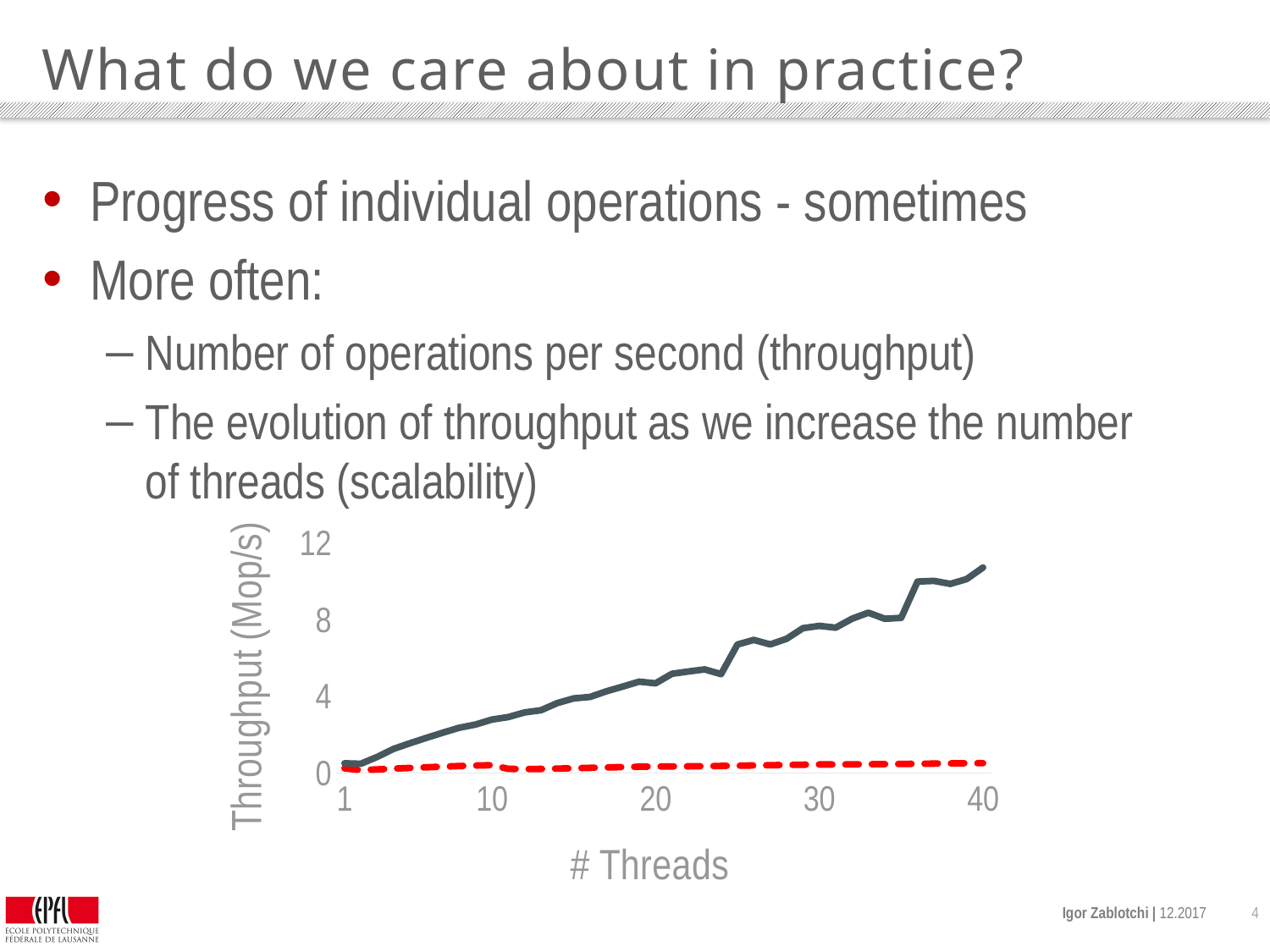
How many lines are plotted on the chart? 2 Is the value of the solid dark line at 30 threads greater or less than 4? greater What is the highest tick value shown on the y axis? 12 What is the label of the y axis of the chart? Throughput (Mop/s) At 40 threads, which line has the larger value, the solid dark line or the dashed red line? the solid dark line Is the value of the solid dark line at 10 threads greater or less than 4? less Does the solid dark line rise or fall as the number of threads increases? rise What is the label of the x axis of the chart? # Threads At which number of threads does the solid dark line reach its highest value? 40 Is the value of the solid dark line at 40 threads greater or less than 8? greater What kind of chart is shown on the slide? line chart